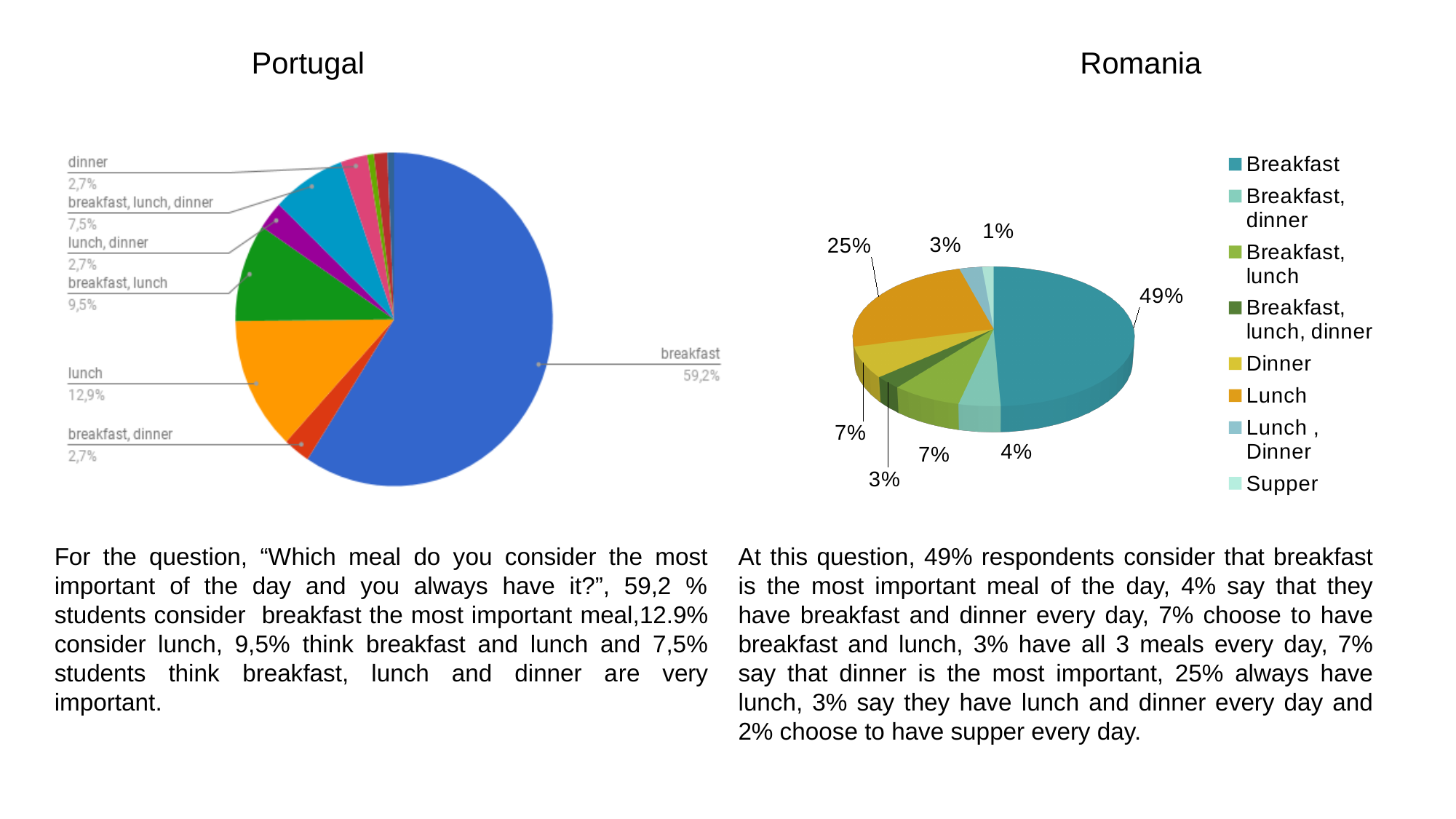
In the Portugal pie chart, what percentage is shown for lunch? 12,9% In the Portugal pie chart, what percentage is shown for 'breakfast, lunch, dinner'? 7,5% In the Portugal pie chart, what percentage of students chose breakfast? 59,2% In the Romania pie chart, what percentage is shown for Supper? 1% In the Romania pie chart, what percentage is shown for Breakfast? 49% What type of chart is used for the Romania data? Pie chart How many entries does the legend of the Romania pie chart list? 8 In the Romania pie chart, which category has the largest share? Breakfast In the Portugal pie chart, which labelled category has the largest share? breakfast In the Romania pie chart, what percentage is shown for Lunch? 25% In the Portugal pie chart, which is larger: 'breakfast, lunch' or 'breakfast, lunch, dinner'? breakfast, lunch In the Portugal pie chart, what is the difference between the breakfast share and the lunch share? 46,3%